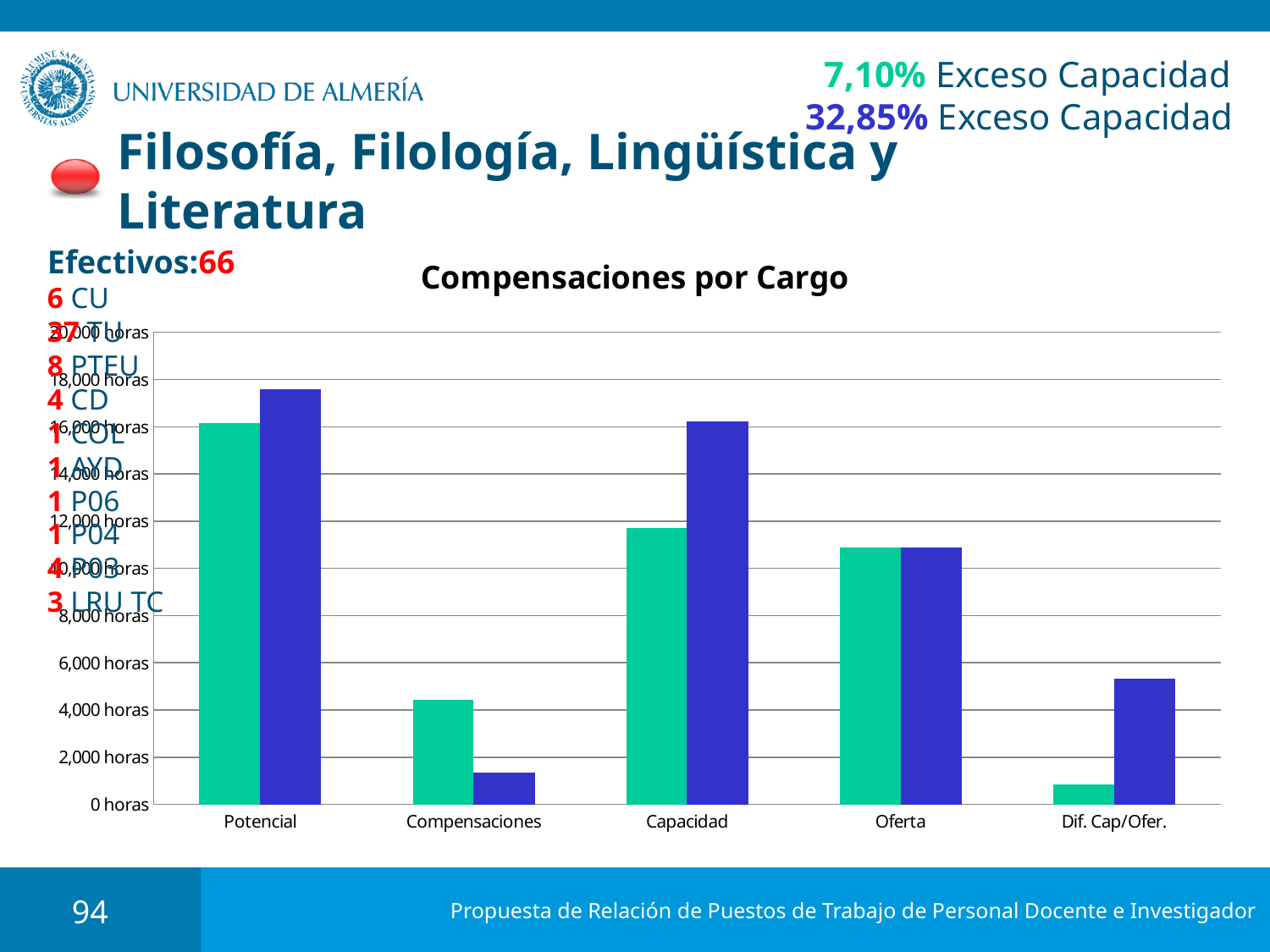
What kind of chart is shown under the title 'Compensaciones por Cargo'? bar chart What is the title of the chart on the slide? Compensaciones por Cargo Is the green bar for Potencial greater or less than 14,000 horas? greater Which category has the tallest green bar in the 'Compensaciones por Cargo' chart? Potencial Which category has the shortest blue bar in the 'Compensaciones por Cargo' chart? Compensaciones For Compensaciones, which bar is taller, the green one or the blue one? the green one Which category has the tallest blue bar in the 'Compensaciones por Cargo' chart? Potencial Is the blue bar for Compensaciones greater or less than 2,000 horas? less How many categories are shown on the x axis of the 'Compensaciones por Cargo' chart? 5 Is the blue bar for Capacidad greater or less than 14,000 horas? greater For Capacidad, which bar is taller, the green one or the blue one? the blue one Which category has the shortest green bar in the 'Compensaciones por Cargo' chart? Dif. Cap/Ofer.